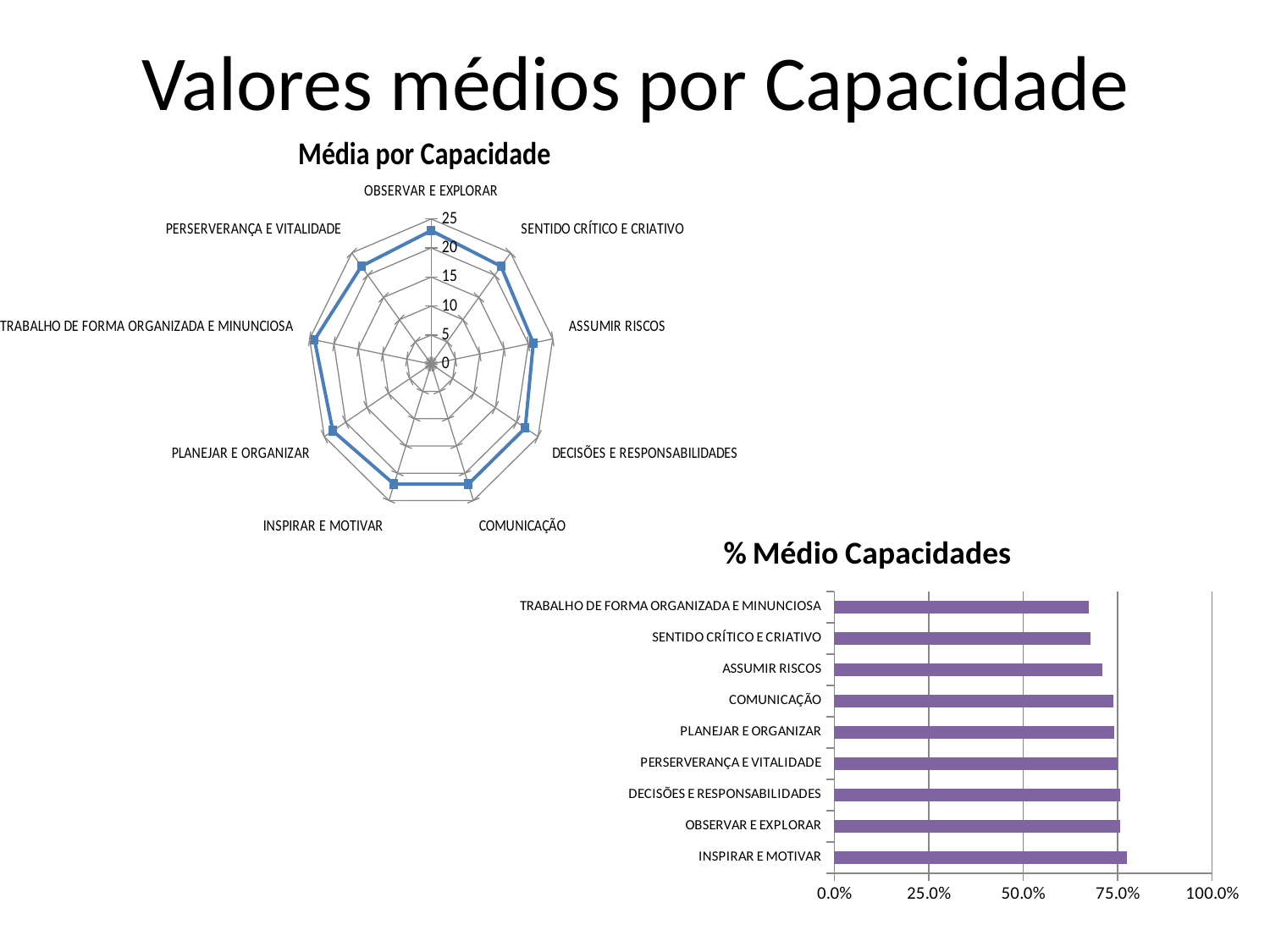
What kind of chart is the chart titled "Média por Capacidade"? radar chart In the chart titled "% Médio Capacidades", how many categories are shown? 9 In the chart titled "Média por Capacidade", how many categories are plotted around the radar? 9 In the chart titled "% Médio Capacidades", which category has the highest value? INSPIRAR E MOTIVAR In the chart titled "Média por Capacidade", is the value for OBSERVAR E EXPLORAR greater or less than 15? greater In the chart titled "% Médio Capacidades", is the value for INSPIRAR E MOTIVAR greater or less than 75.0%? greater In the chart titled "% Médio Capacidades", is the value for TRABALHO DE FORMA ORGANIZADA E MINUNCIOSA greater or less than 50.0%? greater What is the title of the radar chart on the slide? Média por Capacidade What kind of chart is the chart titled "% Médio Capacidades"? bar chart In the chart titled "% Médio Capacidades", which is larger: the value for INSPIRAR E MOTIVAR or the value for ASSUMIR RISCOS? INSPIRAR E MOTIVAR In the chart titled "% Médio Capacidades", which is larger: the value for COMUNICAÇÃO or the value for TRABALHO DE FORMA ORGANIZADA E MINUNCIOSA? COMUNICAÇÃO